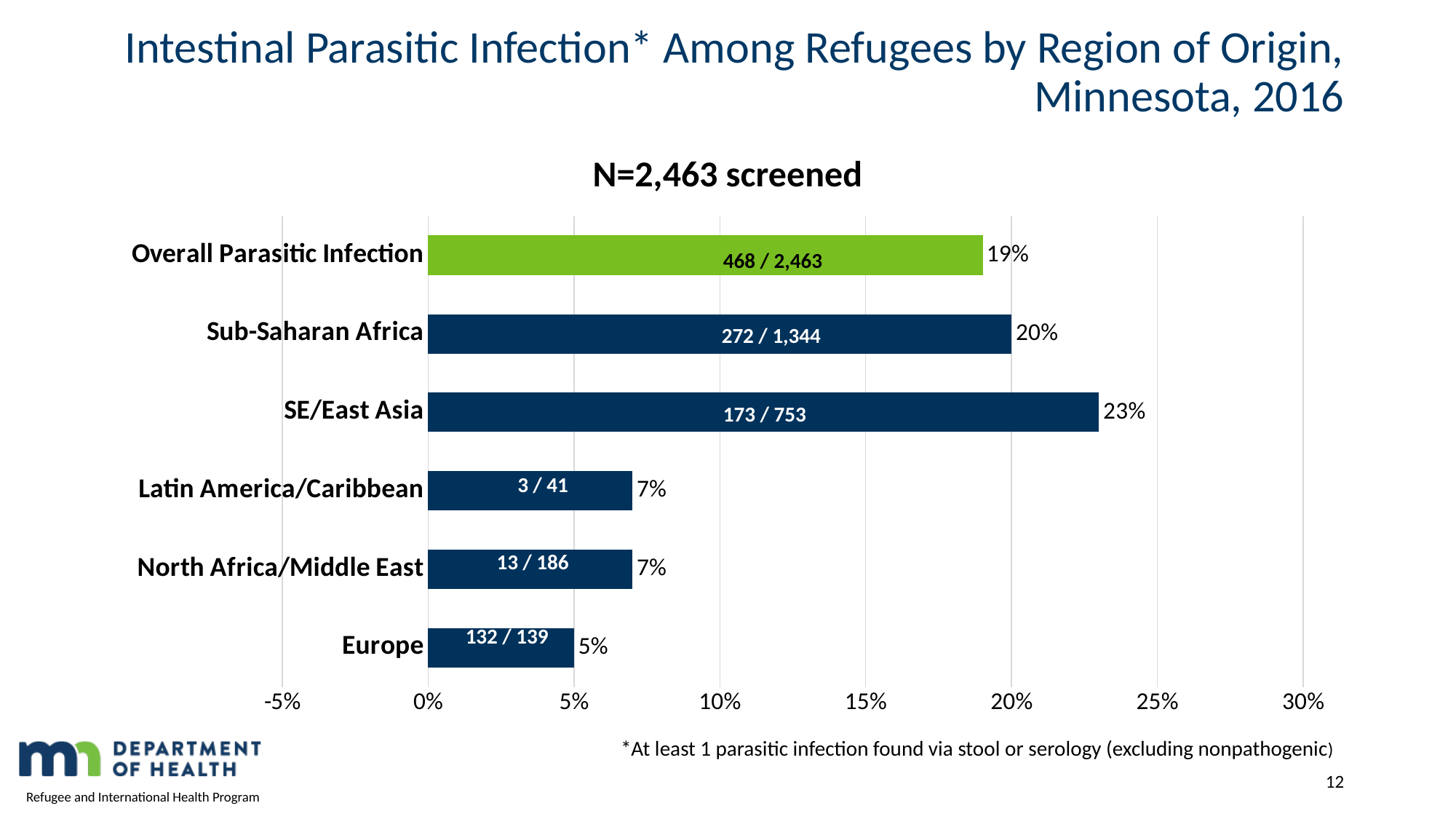
What fraction label is printed on the Overall Parasitic Infection bar? 468 / 2,463 What is the percentage shown for SE/East Asia? 23% Which region has the lowest percentage of parasitic infection? Europe What is the difference in percentage points between SE/East Asia and Sub-Saharan Africa? 3% What is the percentage shown for Sub-Saharan Africa? 20% Which region has the highest percentage of parasitic infection? SE/East Asia What is the percentage shown for Europe? 5% What is the total number screened stated above the chart? N=2,463 screened Which has a higher percentage, Sub-Saharan Africa or Overall Parasitic Infection? Sub-Saharan Africa How many bars are shown in the chart? 6 What type of chart is shown on the slide? Bar chart What fraction label is printed on the Latin America/Caribbean bar? 3 / 41